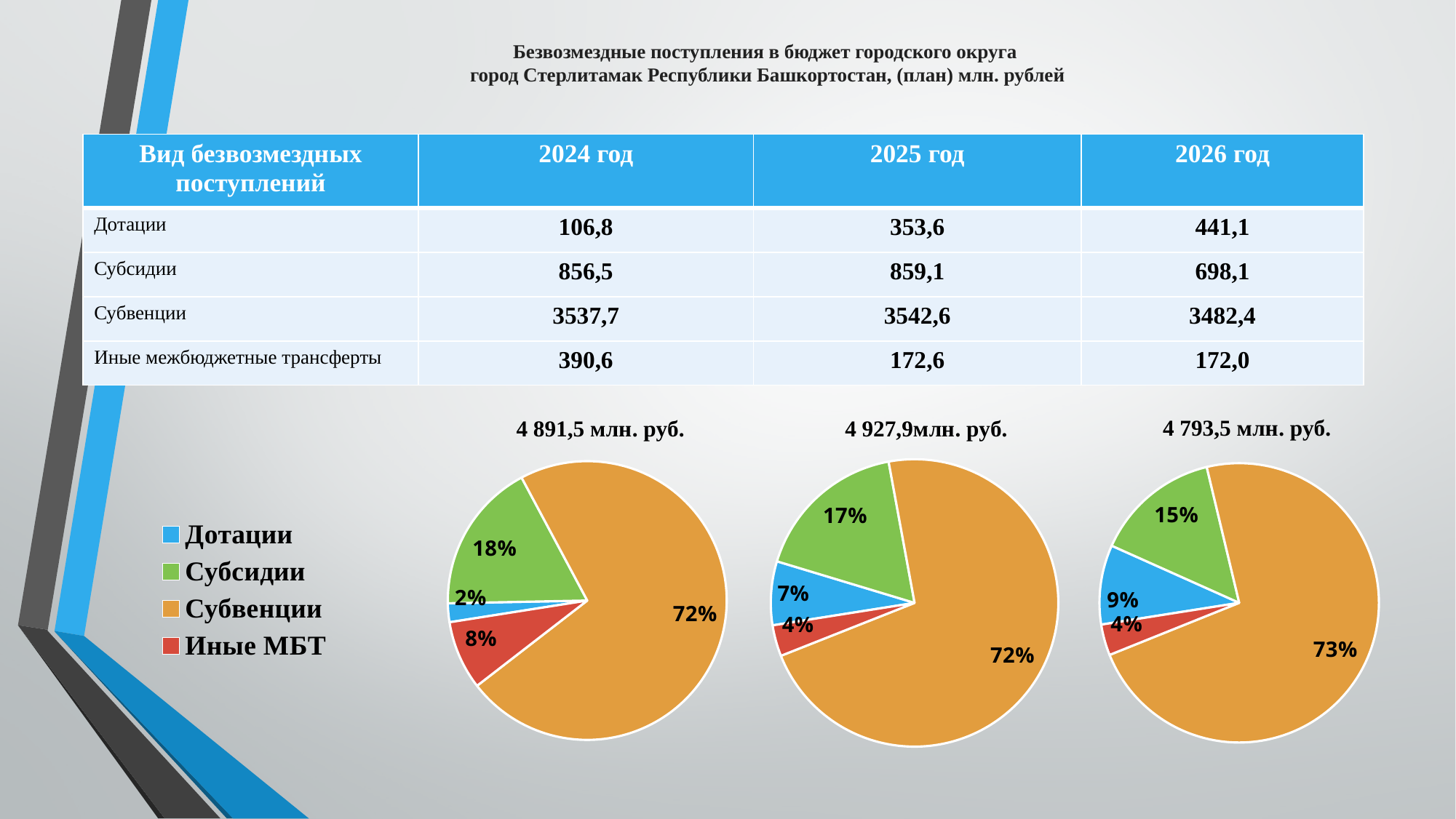
In the left pie chart (4 891,5 млн. руб.), what share is labelled for Иные МБТ? 8% Which colour represents Субвенции in the pie charts' legend? Orange What kind of charts are shown on the slide? Pie charts How many pie charts are on the slide? 3 In the left pie chart (4 891,5 млн. руб.), what share is labelled for Субвенции? 72% In the right pie chart (4 793,5 млн. руб.), what share is labelled for Субвенции? 73% In the right pie chart (4 793,5 млн. руб.), what is the difference between the Субсидии share and the Дотации share? 6% In the right pie chart (4 793,5 млн. руб.), which category has the smallest slice? Иные МБТ How many entries does the legend list for the pie charts? 4